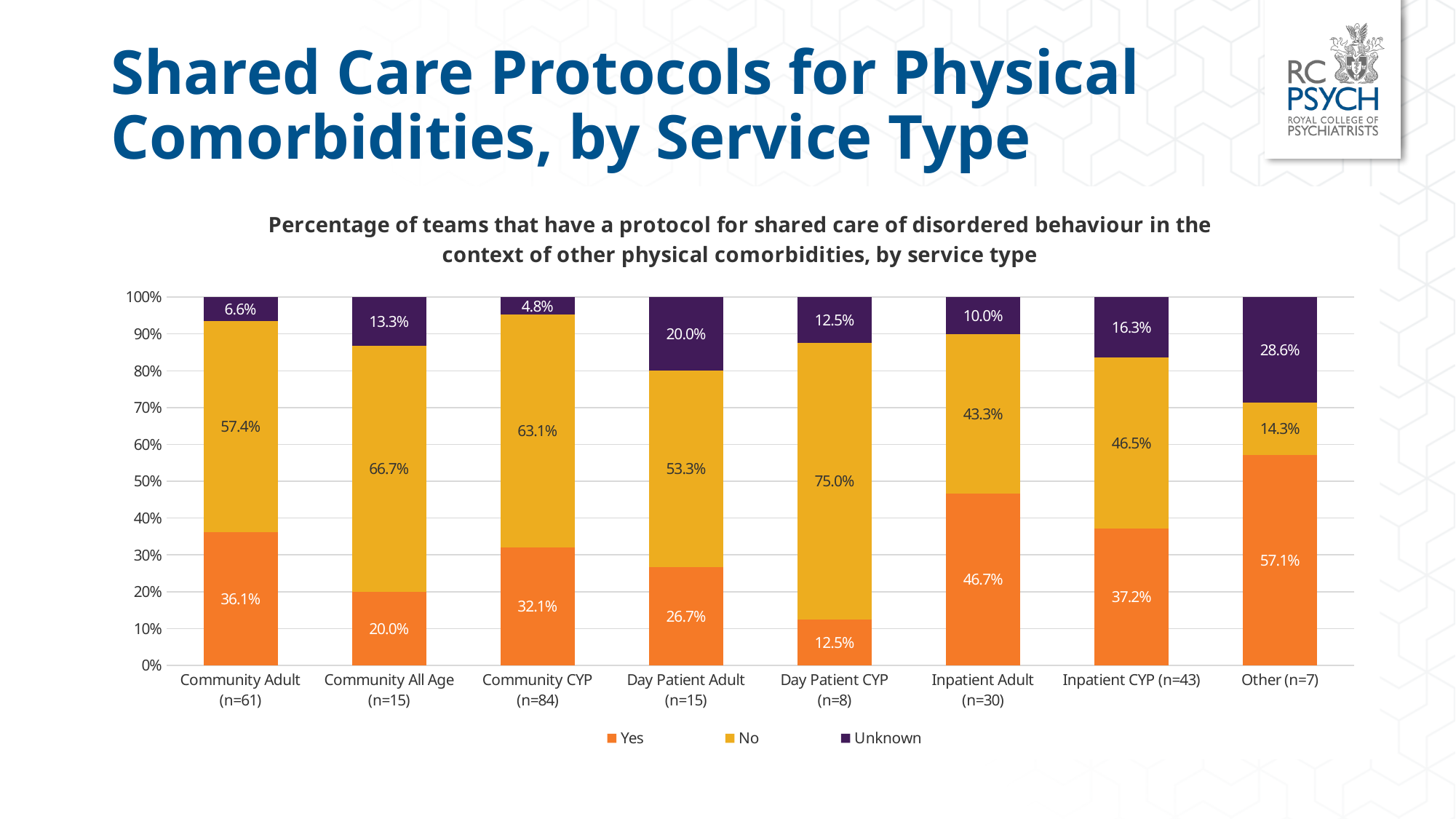
What is the difference between the Yes percentages for Inpatient Adult (n=30) and Inpatient CYP (n=43)? 9.5% What is the No percentage for Day Patient CYP (n=8)? 75.0% What is the Unknown percentage for Other (n=7)? 28.6% Which service type has the lowest Unknown percentage? Community CYP (n=84) Which is larger: the No percentage for Community All Age (n=15) or for Community CYP (n=84)? Community All Age (n=15) How many service types are shown on the x axis? 8 Which service type has the lowest Yes percentage? Day Patient CYP (n=8) How many series does the legend list? 3 Which service type has the highest Yes percentage? Other (n=7) What percentage of Community Adult (n=61) teams answered Yes? 36.1% What kind of chart is shown? Stacked bar chart Which colour represents the Unknown series? Dark purple